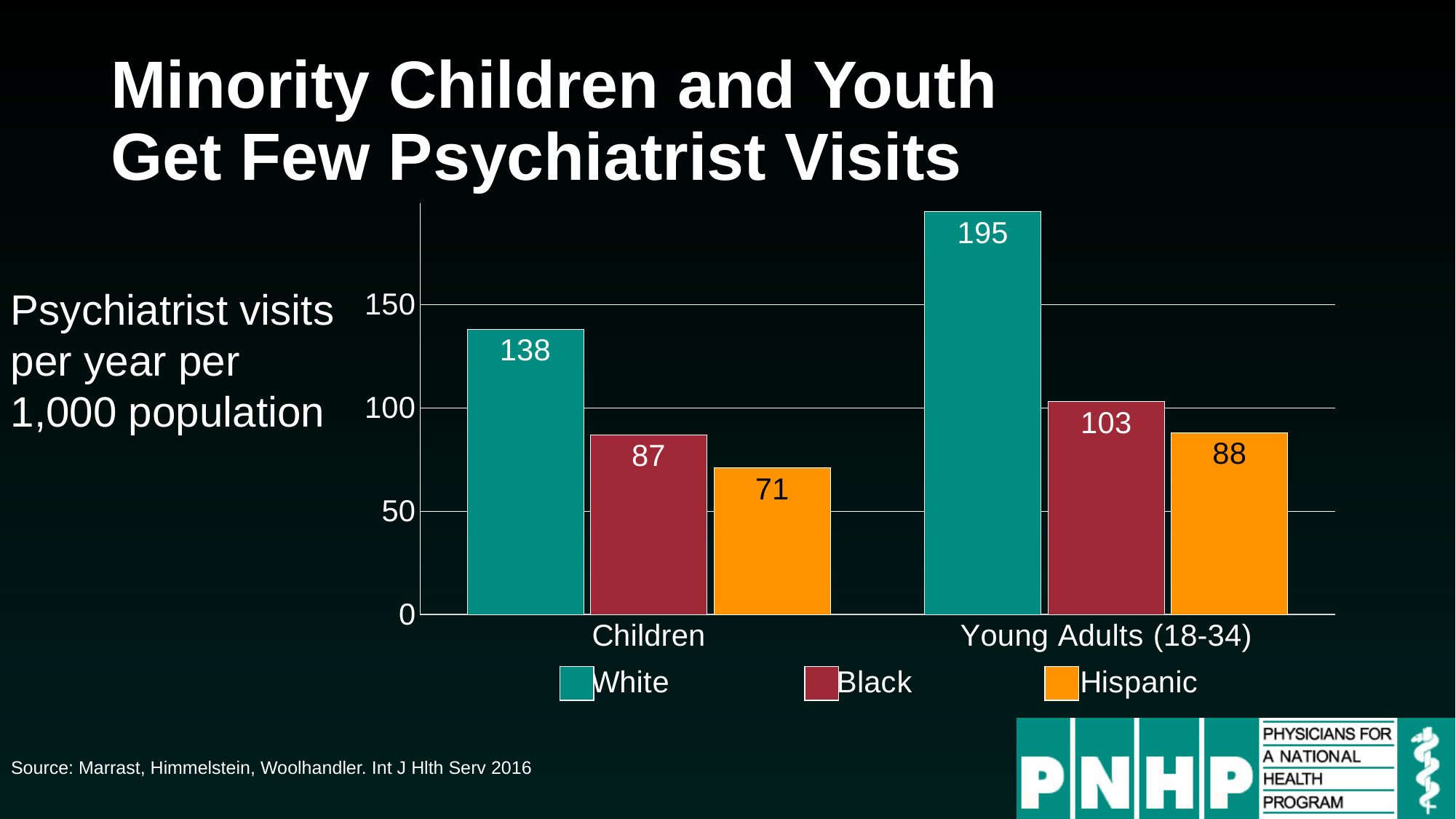
Which series has the lowest value in the Children group? Hispanic What is the difference between the White and Black values in the Young Adults (18-34) group? 92 Is the value for White in the Young Adults (18-34) group greater or less than 150? greater What is the value for Black in the Children group? 87 What is the value for Hispanic in the Young Adults (18-34) group? 88 What is the value for White in the Children group? 138 How many series does the legend list? 3 What is the difference between the White values for Young Adults (18-34) and Children? 57 Which is larger, the Black value for Children or the Hispanic value for Young Adults (18-34)? Hispanic value for Young Adults (18-34) What kind of chart is shown on the slide? bar chart What does the y axis of the chart measure? Psychiatrist visits per year per 1,000 population Which series has the highest value in the Young Adults (18-34) group? White